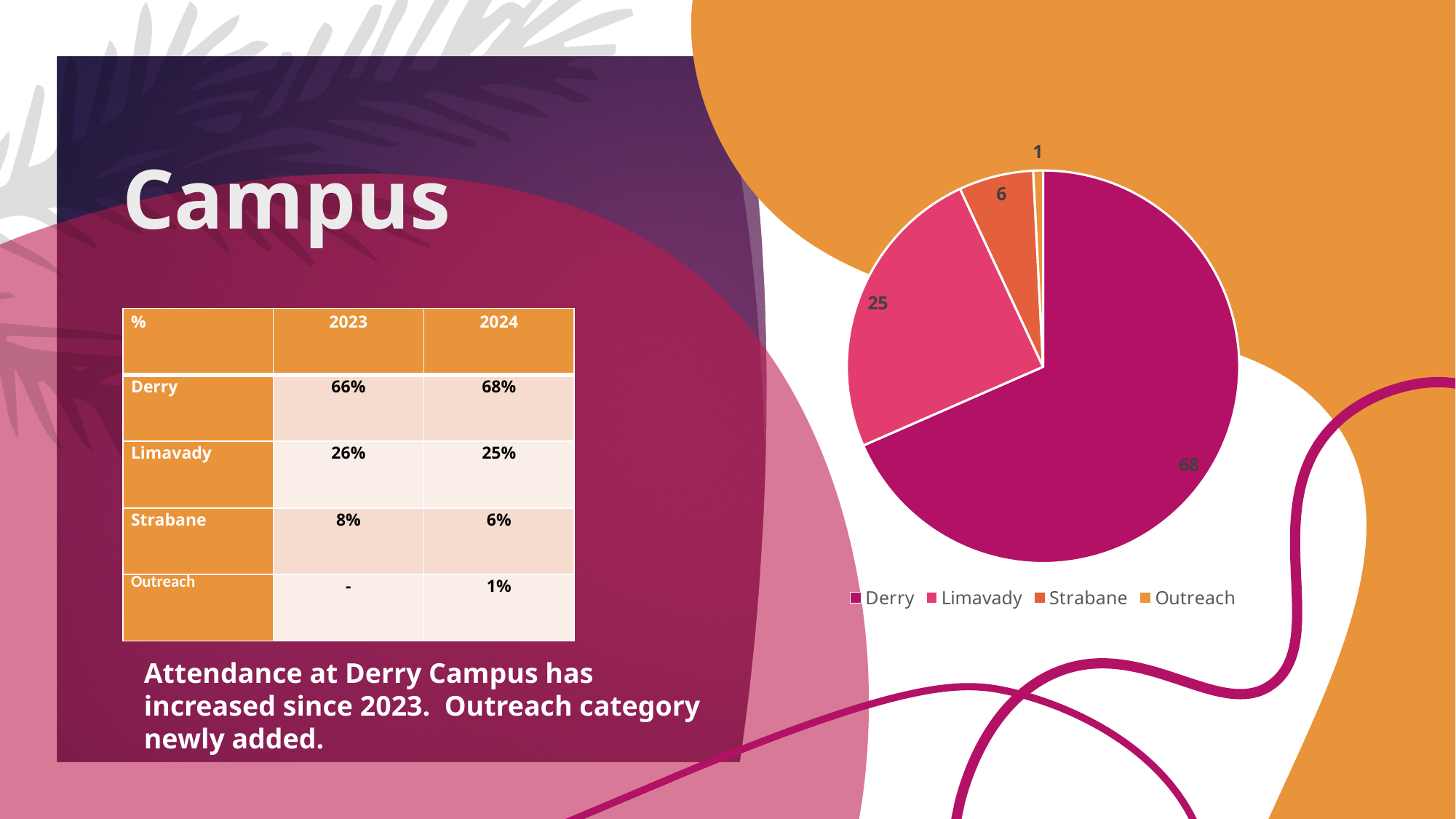
How many slices does the pie chart have? 4 Which is larger in the pie chart, Limavady or Strabane? Limavady What kind of chart is shown on the slide? pie chart Which category has the largest slice in the pie chart? Derry What is the difference between the values for Derry and Limavady in the pie chart? 43 What is the value shown for Limavady in the pie chart? 25 What is the value shown for Derry in the pie chart? 68 Which legend entry in the pie chart is shown in orange? Outreach What is the value shown for Outreach in the pie chart? 1 What is the value shown for Strabane in the pie chart? 6 How many entries does the pie chart legend list? 4 Which category has the smallest slice in the pie chart? Outreach